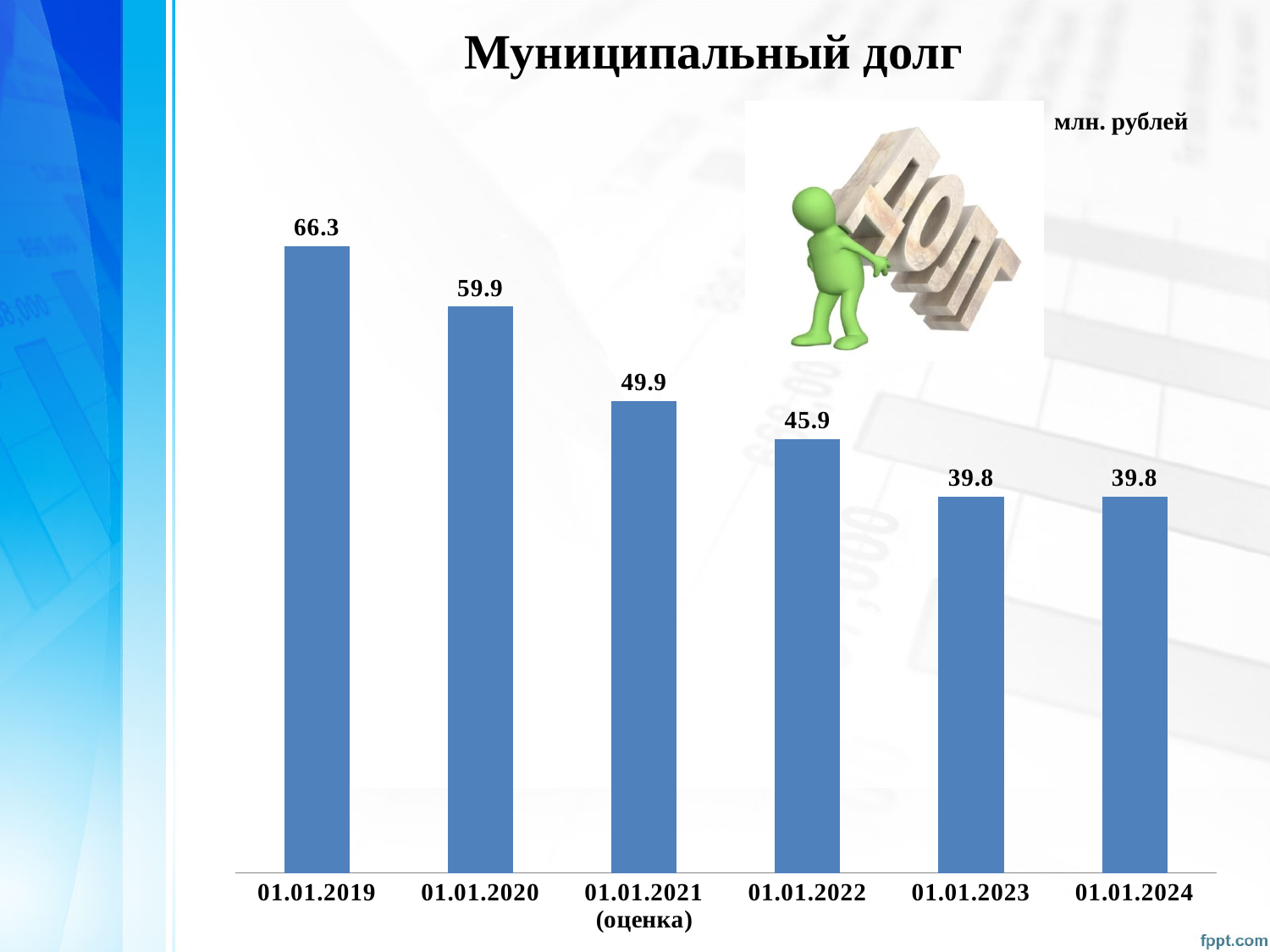
What is the municipal debt value for 01.01.2019? 66.3 Which date has the highest municipal debt? 01.01.2019 What is the municipal debt value for 01.01.2021 (оценка)? 49.9 What is the municipal debt value for 01.01.2022? 45.9 What is the title of the chart? Муниципальный долг Do the values generally rise or fall from 01.01.2019 to 01.01.2024? fall What kind of chart is shown on the slide? bar chart Which is larger, the value for 01.01.2020 or the value for 01.01.2022? 01.01.2020 How many dates (categories) are shown on the chart? 6 In what units are the values on the chart expressed? млн. рублей What is the difference between the values for 01.01.2021 (оценка) and 01.01.2022? 4.0 What is the difference between the values for 01.01.2019 and 01.01.2020? 6.4